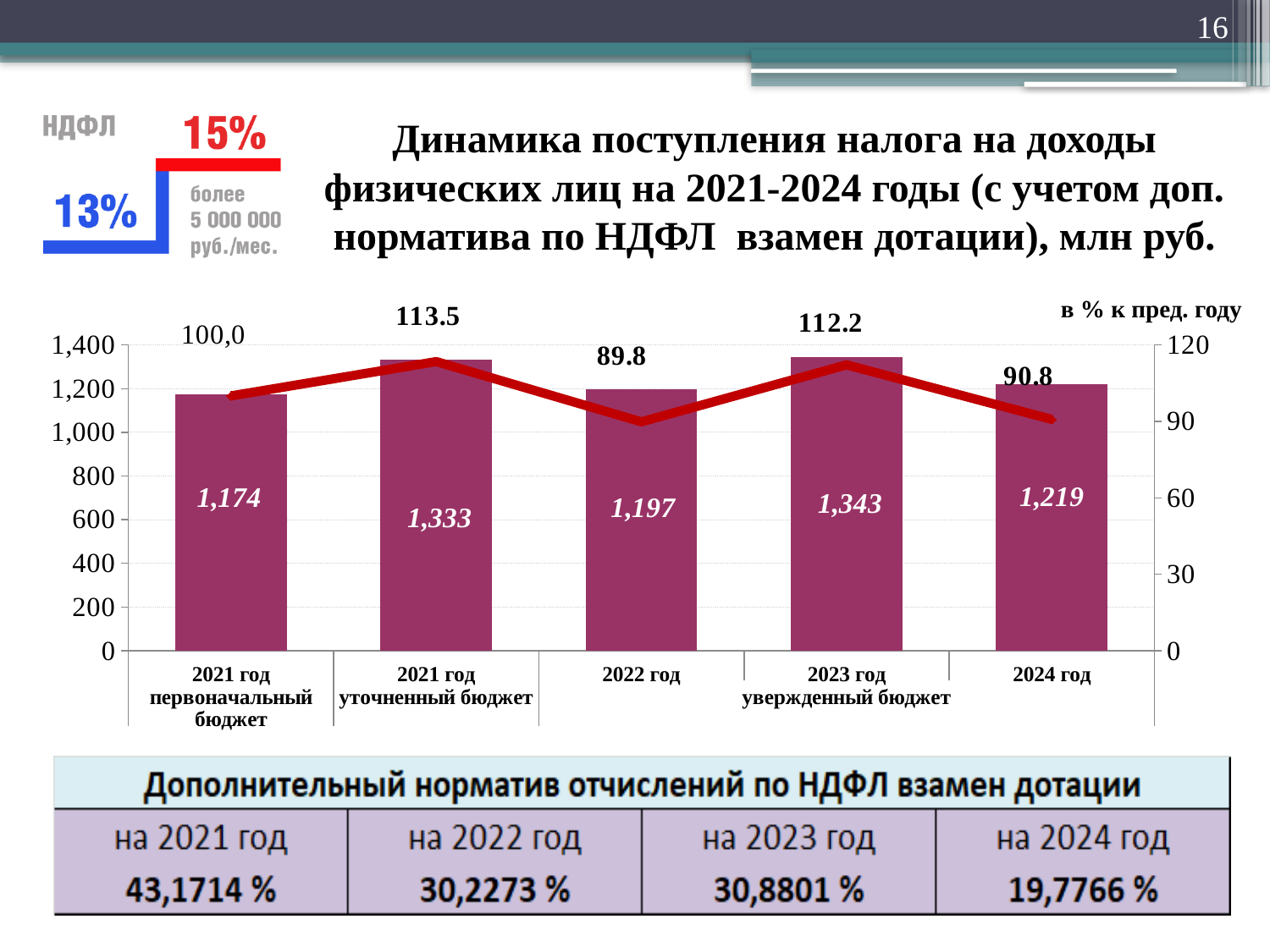
What is the line value (в % к пред. году) for 2024 год? 90.8 How many categories are shown on the x axis of the chart? 5 What is the line value (в % к пред. году) for 2023 год? 112.2 What kind of chart is shown on the slide? Combined bar and line chart What is the label of the right-hand axis of the chart? в % к пред. году Is the bar value for 2024 год greater or less than 1,000? greater What is the difference between the bar values for 2023 год and 2024 год? 124 Which category has the highest bar value? 2023 год What is the bar value for 2021 год уточненный бюджет? 1,333 Which category has the lowest bar value? 2021 год первоначальный бюджет Which is larger, the bar value for 2022 год or for 2021 год первоначальный бюджет? 2022 год What is the bar value for 2022 год? 1,197